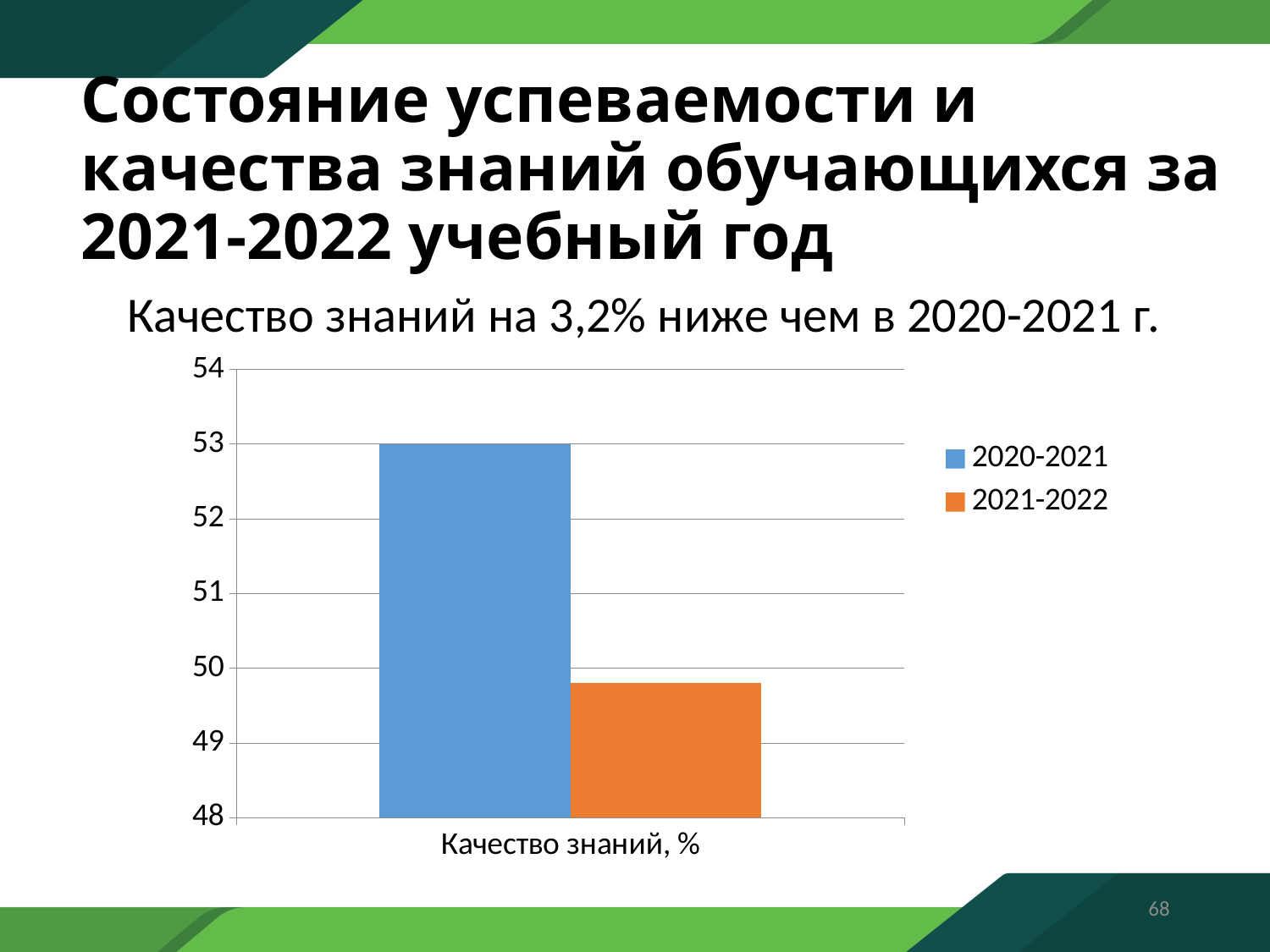
Is the value for 2020-2021 greater or less than 52? greater How many categories are shown on the x axis? 1 How many series does the legend list? 2 Is the value for 2021-2022 greater or less than 50? less What are the two entries in the legend? 2020-2021 and 2021-2022 What is the value for the 2020-2021 series? 53 Which series has the higher value? 2020-2021 Which series has the lower value? 2021-2022 What kind of chart is shown on the slide? bar chart Is the value for 2021-2022 greater or less than 49? greater What is the label of the category on the x axis? Качество знаний, % Which is larger, the value for 2020-2021 or the value for 2021-2022? 2020-2021